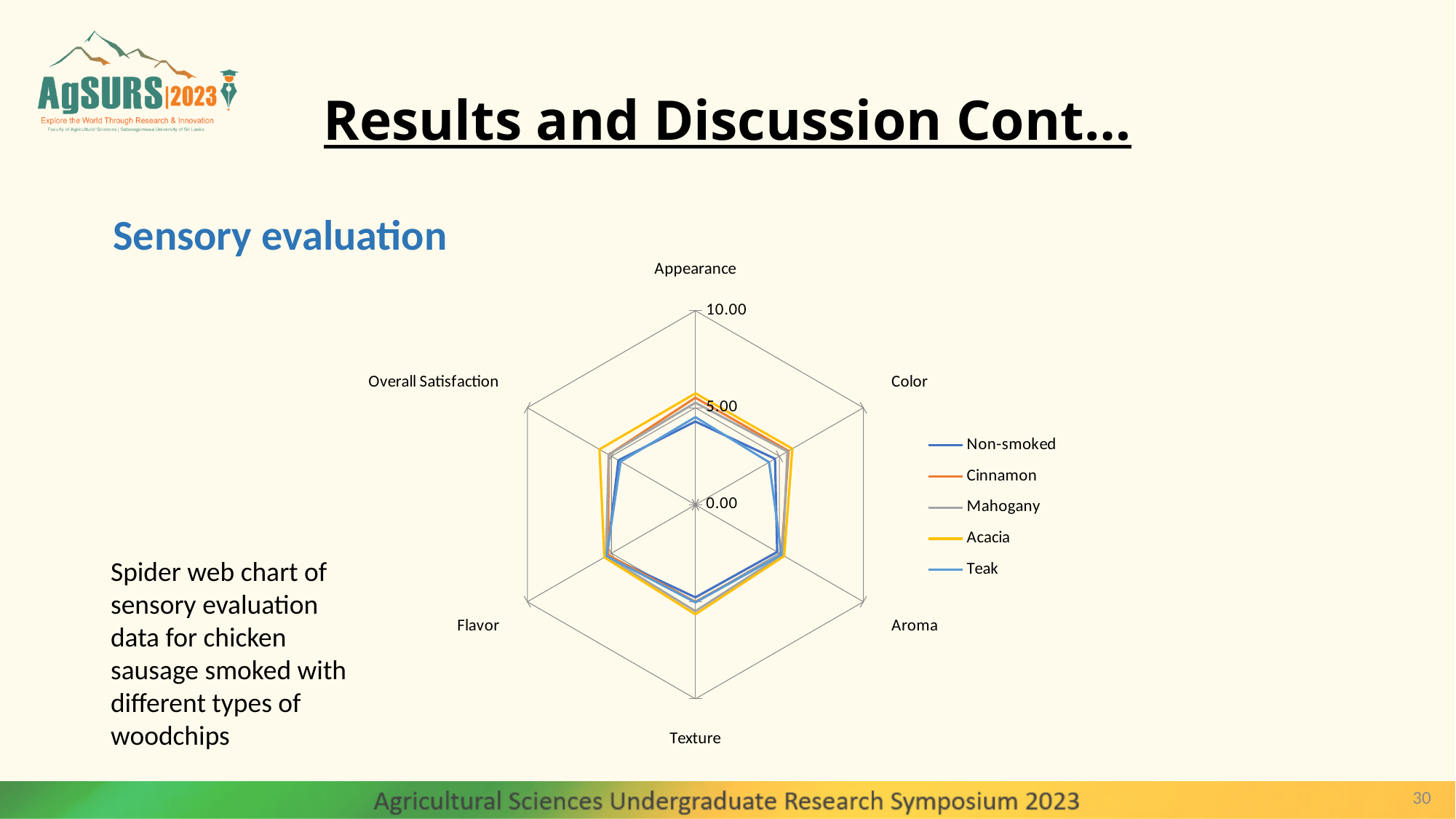
How many series does the legend of the spider web chart list? 5 Is the Acacia value for Texture greater or less than 10.00? less What kind of chart is shown on the slide? Radar (spider web) chart How many sensory attributes (axes) does the spider web chart have? 6 Is the Non-smoked value for Overall Satisfaction greater or less than 10.00? less For Texture, which series has the larger value: Acacia or Non-smoked? Acacia Which series in the spider web chart is drawn in yellow? Acacia What is the maximum value shown on the radial axis of the spider web chart? 10.00 For Appearance, which series has the larger value: Acacia or Non-smoked? Acacia Which attribute is plotted on the axis at the top of the spider web chart? Appearance